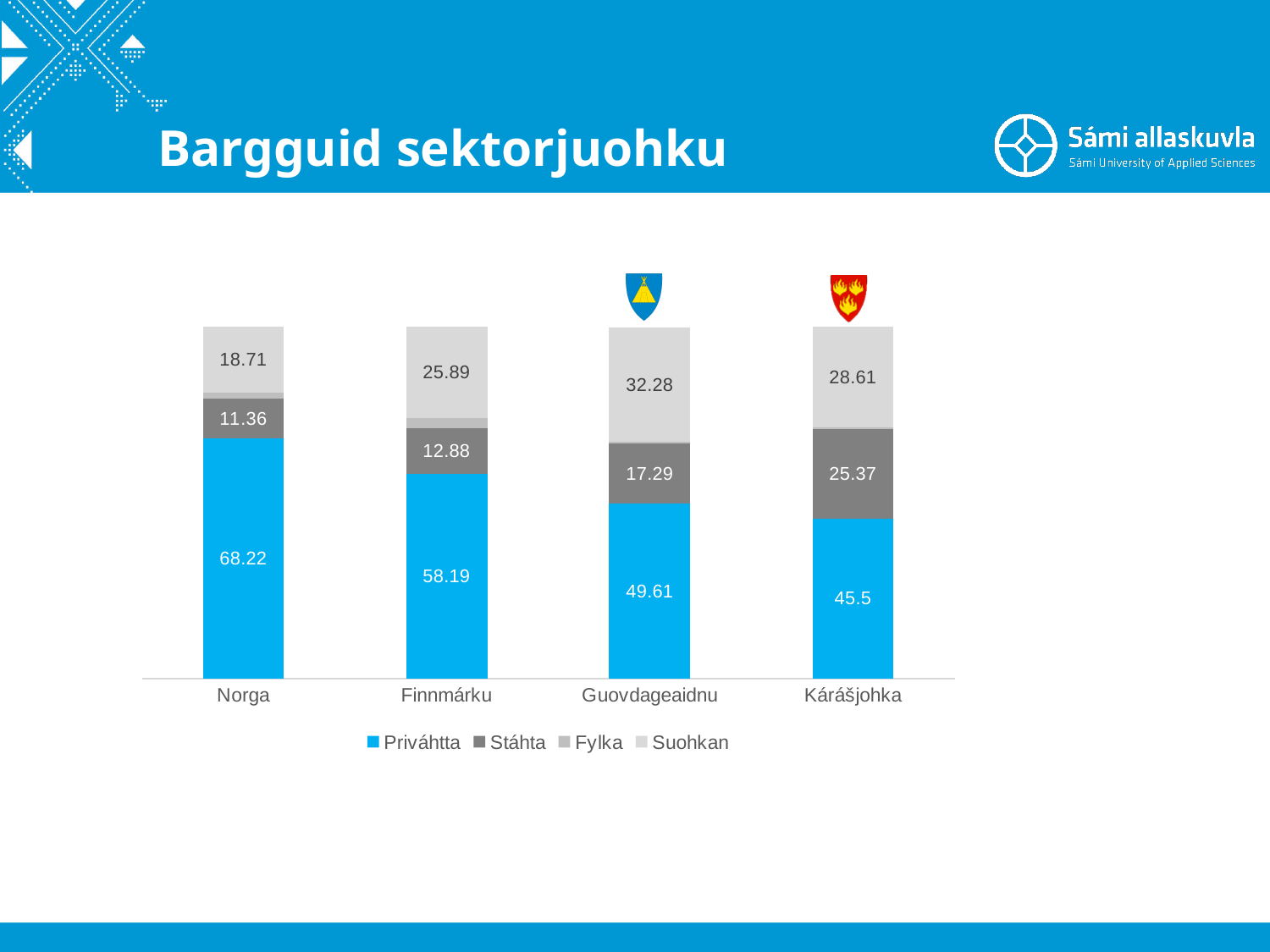
What is the Priváhtta value for Norga? 68.22 Do the Priváhtta values rise or fall from Norga to Kárášjohka along the x axis? Fall How many series does the legend list? 4 Which category has the highest Priváhtta value? Norga Which is larger, the Suohkan value for Guovdageaidnu or for Kárášjohka? Guovdageaidnu What is the Stáhta value for Kárášjohka? 25.37 Which category has the lowest Stáhta value? Norga What is the Suohkan value for Finnmárku? 25.89 What is the Suohkan value for Guovdageaidnu? 32.28 How many categories are shown on the x axis? 4 What kind of chart is shown on the slide? Stacked bar chart What is the difference between the Priváhtta values for Norga and Kárášjohka? 22.72